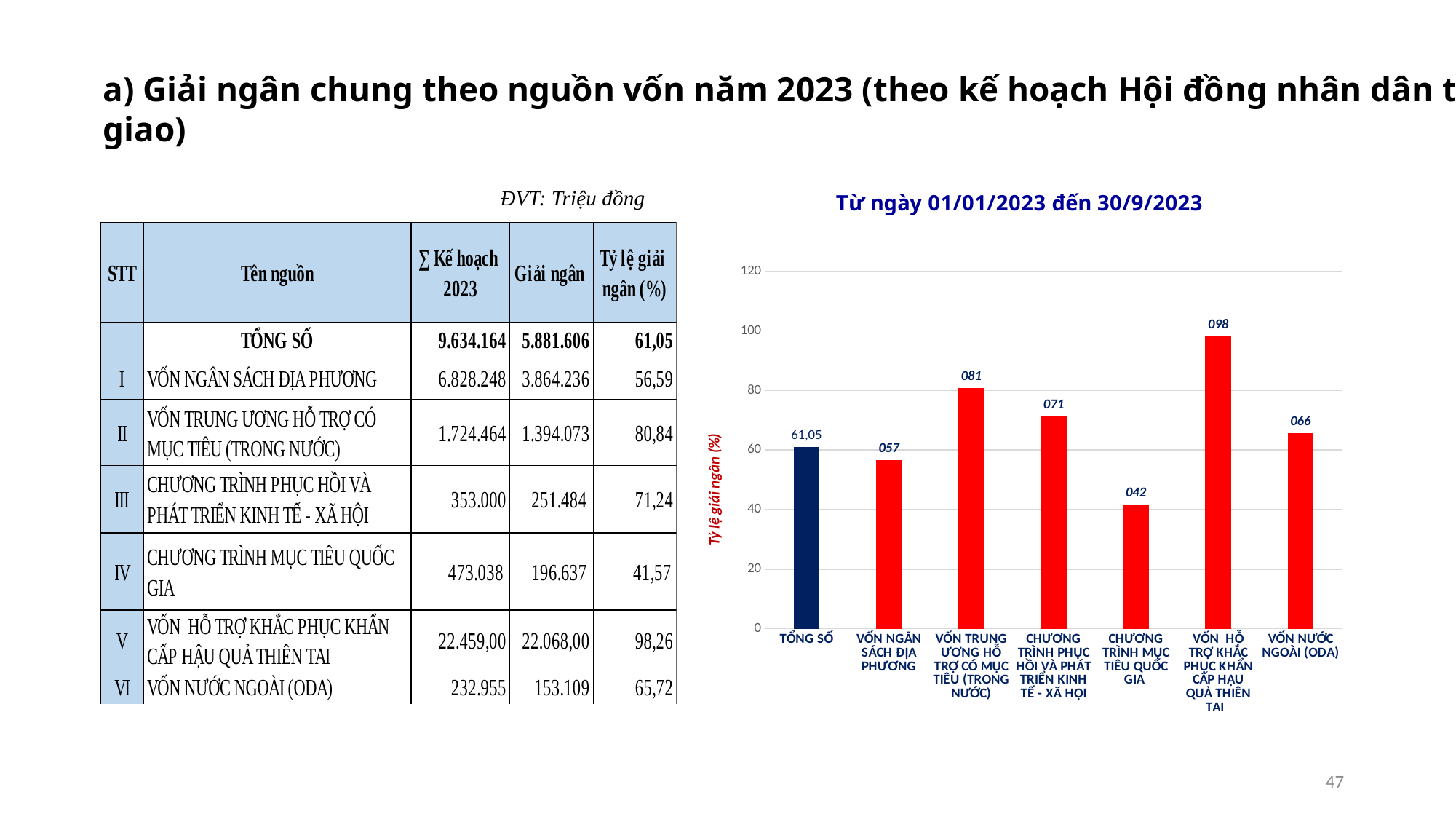
Which category has the highest bar in the chart? VỐN HỖ TRỢ KHẮC PHỤC KHẨN CẤP HẬU QUẢ THIÊN TAI What is the data label shown for CHƯƠNG TRÌNH MỤC TIÊU QUỐC GIA in the chart? 042 How many bars (categories) are plotted in the chart? 7 What is the label on the vertical axis of the chart? Tỷ lệ giải ngân (%) Is the value for VỐN NGÂN SÁCH ĐỊA PHƯƠNG greater or less than 60? less What type of chart is shown on the slide? Bar chart Using the printed data labels, what is the difference between the values for VỐN HỖ TRỢ KHẮC PHỤC KHẨN CẤP HẬU QUẢ THIÊN TAI (098) and CHƯƠNG TRÌNH MỤC TIÊU QUỐC GIA (042)? 56 Which category has the lowest bar in the chart? CHƯƠNG TRÌNH MỤC TIÊU QUỐC GIA Which is larger in the chart: VỐN TRUNG ƯƠNG HỖ TRỢ CÓ MỤC TIÊU (TRONG NƯỚC) or CHƯƠNG TRÌNH PHỤC HỒI VÀ PHÁT TRIỂN KINH TẾ - XÃ HỘI? VỐN TRUNG ƯƠNG HỖ TRỢ CÓ MỤC TIÊU (TRONG NƯỚC) What is the data label shown for TỔNG SỐ in the chart? 61,05 What is the title of the chart? Từ ngày 01/01/2023 đến 30/9/2023 What is the data label shown for VỐN NƯỚC NGOÀI (ODA) in the chart? 066